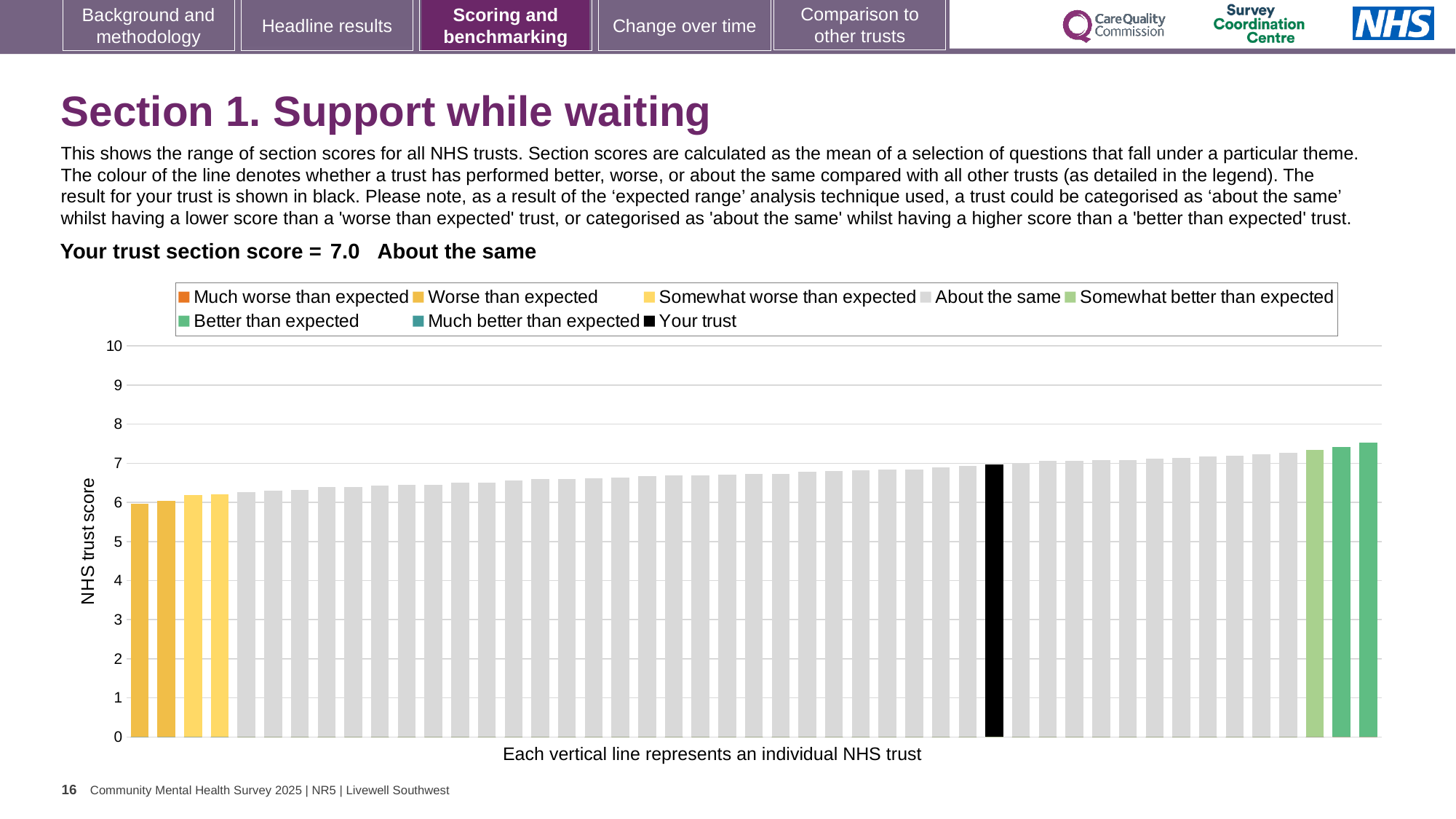
What is the section score for your trust shown on the slide? 7.0 Is the value of the black 'Your trust' bar greater or less than 5? greater Do the bar values rise or fall from left to right along the x axis? rise What colour is the bar representing your trust? black Is the value of the tallest bar greater or less than 8? less How many bars are shown in the 'Better than expected' green colour? 2 Is the value of the shortest bar greater or less than 5? greater What kind of chart is shown on the slide? bar chart What is the label on the vertical axis of the chart? NHS trust score How many entries does the chart legend list? 8 Which category is your trust placed in for this section? About the same